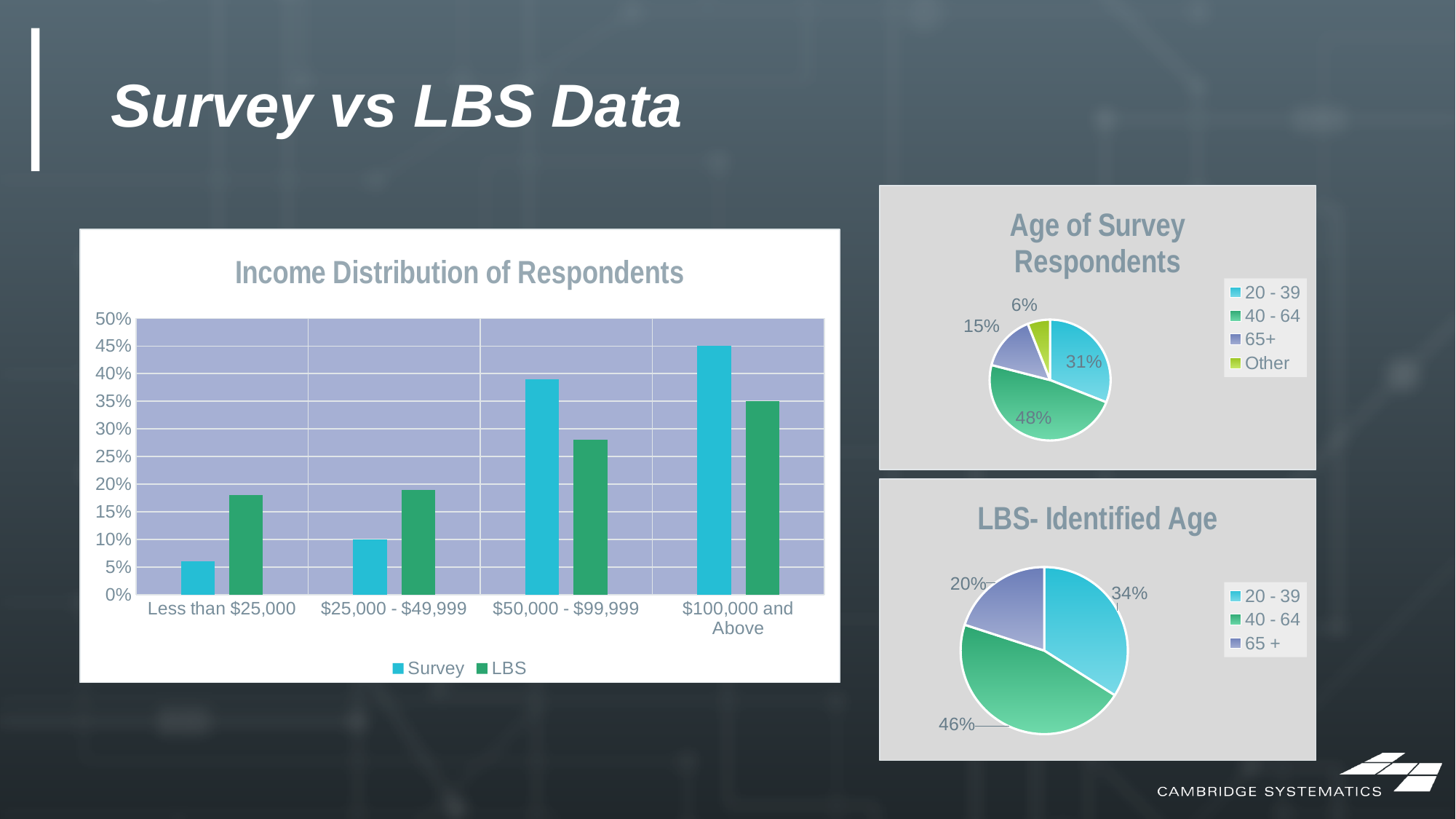
In the Income Distribution of Respondents chart, for the Less than $25,000 category, which series has the larger value, Survey or LBS? LBS In the LBS- Identified Age pie chart, what is the difference between the 40 - 64 share and the 20 - 39 share? 12% In the Income Distribution of Respondents chart, do the Survey values rise or fall as income increases along the x axis? Rise In the Income Distribution of Respondents chart, is the LBS value for Less than $25,000 greater or less than 15%? greater In the Income Distribution of Respondents chart, how many income categories are shown on the x axis? 4 In the Age of Survey Respondents pie chart, what is the value for the Other slice? 6% In the Income Distribution of Respondents chart, how many series does the legend list? 2 In the Age of Survey Respondents pie chart, what share is the 40 - 64 group? 48% In the LBS- Identified Age pie chart, what is the value for the 65 + group? 20% What kind of chart is the Income Distribution of Respondents chart? Bar chart In the Income Distribution of Respondents chart, which income category has the highest Survey value? $100,000 and Above In the Income Distribution of Respondents chart, is the Survey value for $50,000 - $99,999 greater or less than 35%? greater